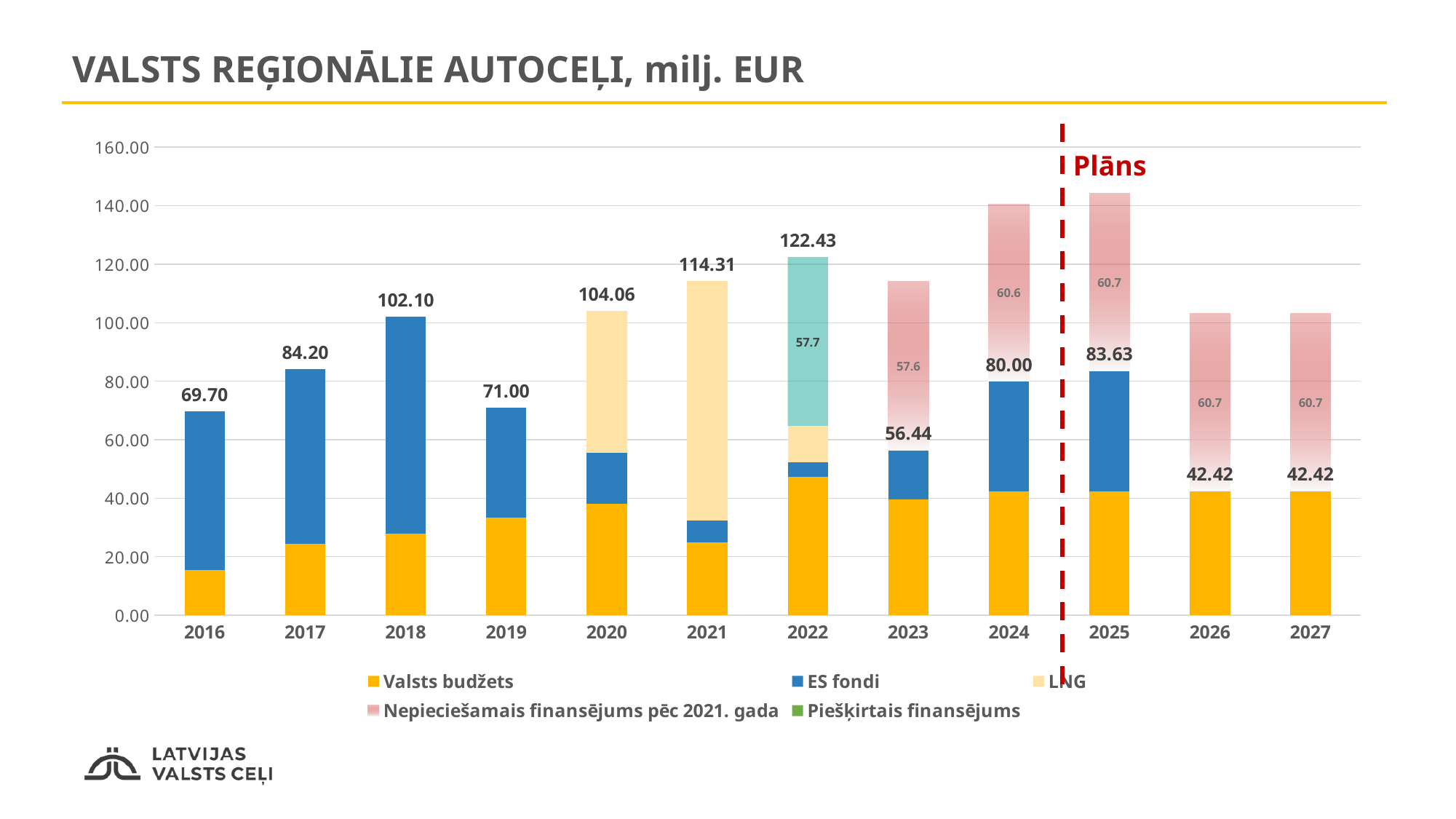
What value is printed on the pink segment for 2024? 60.6 Which year has the highest labelled total value? 2022 What is the difference between the labelled values for 2022 and 2021? 8.12 What is the labelled value for 2021? 114.31 What is the difference between the labelled values for 2018 and 2017? 17.90 How many series does the legend list? 5 Is the total height of the 2026 bar greater or less than 100.00? greater What is the labelled value for 2018? 102.10 Which is larger, the labelled value for 2019 or for 2016? 2019 How many years are shown on the x axis? 12 Is the total height of the 2025 bar greater or less than 140.00? greater What kind of chart is shown on the slide? Stacked bar chart